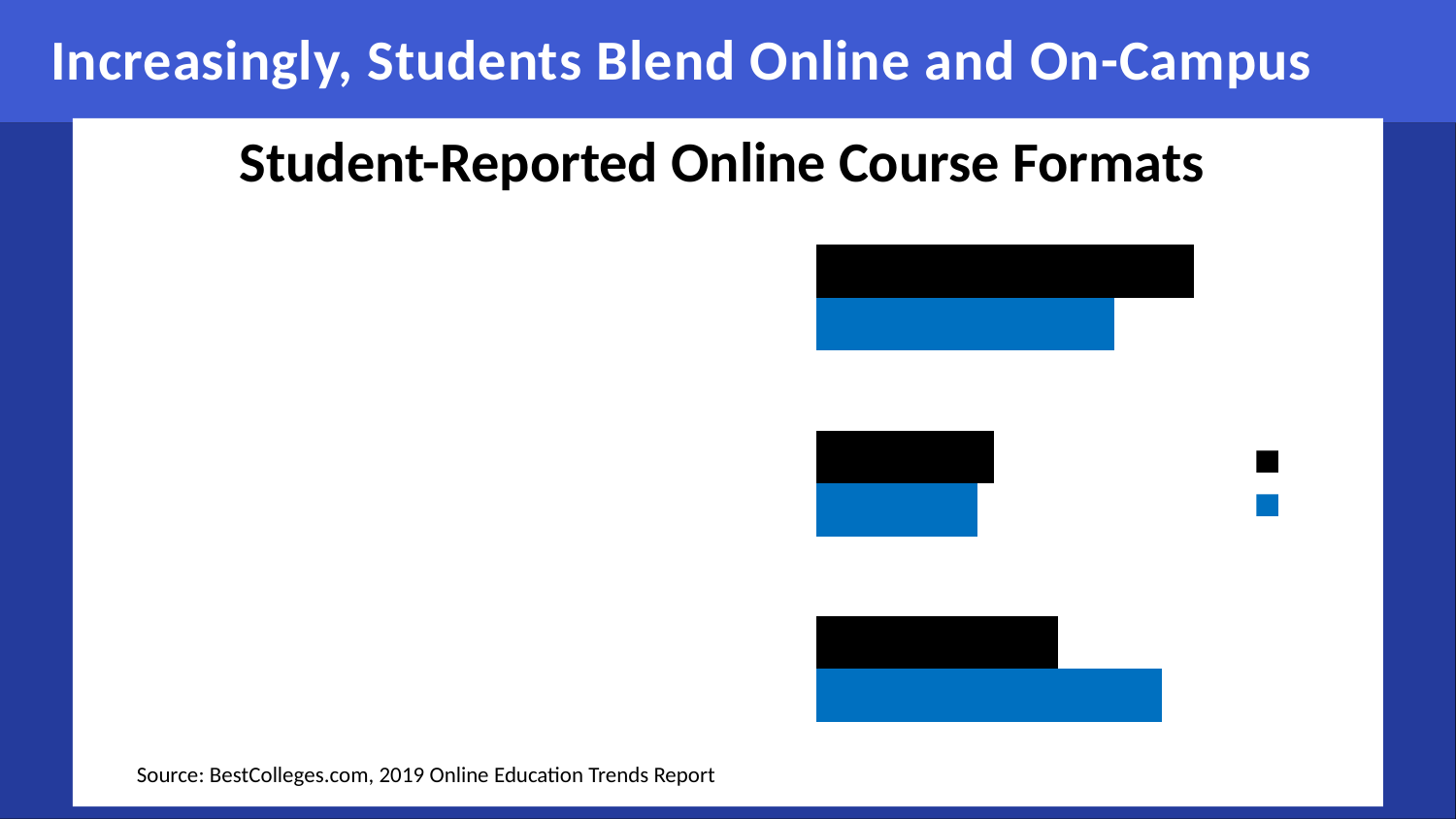
What two colours are used for the bars in the chart? black and blue In the top group of bars, which bar is longer, the black one or the blue one? black How many groups of bars does the chart show? 3 In the middle group of bars, which bar is longer, the black one or the blue one? black What is the title of the chart? Student-Reported Online Course Formats What kind of chart is shown on the slide? bar chart In the bottom group of bars, which bar is longer, the black one or the blue one? blue How many series does the legend list? 2